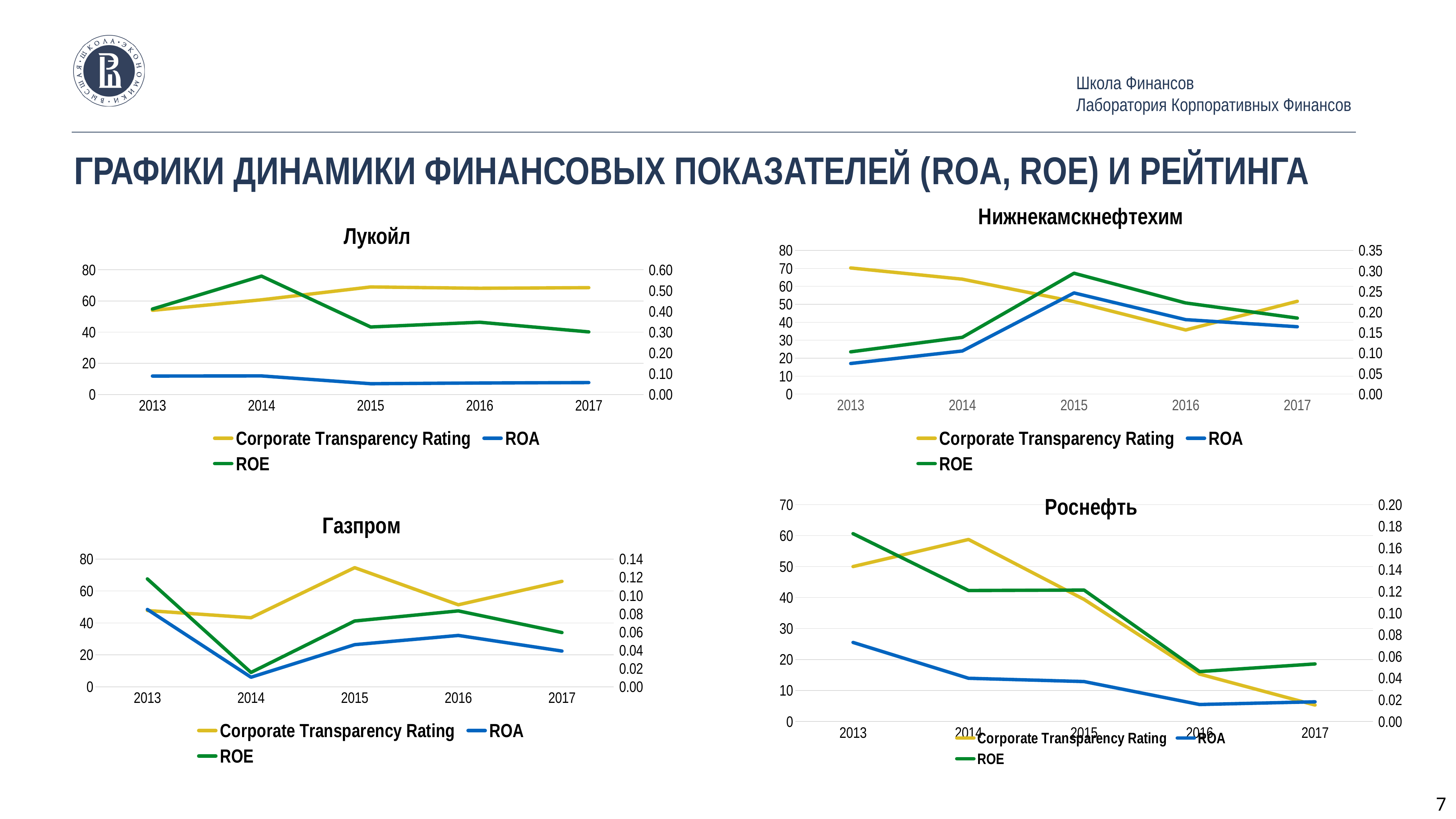
In the Лукойл chart, is the Corporate Transparency Rating for 2013 greater or less than 60? less In the Газпром chart, in which year is the Corporate Transparency Rating highest? 2015 In the Роснефть chart, in which year is the Corporate Transparency Rating highest? 2014 In the Газпром chart, which colour is used for the ROE line? green In the Роснефть chart, in which year is the Corporate Transparency Rating lowest? 2017 In the Нижнекамскнефтехим chart, is the Corporate Transparency Rating for 2013 greater or less than 60? greater In the Роснефть chart, does ROA rise or fall from 2013 to 2017? fall How many years are plotted on the x axis of the Роснефть chart? 5 What kind of chart is the Лукойл chart? line chart In the Лукойл chart, in which year is ROE highest? 2014 How many series does the legend of the Газпром chart list? 3